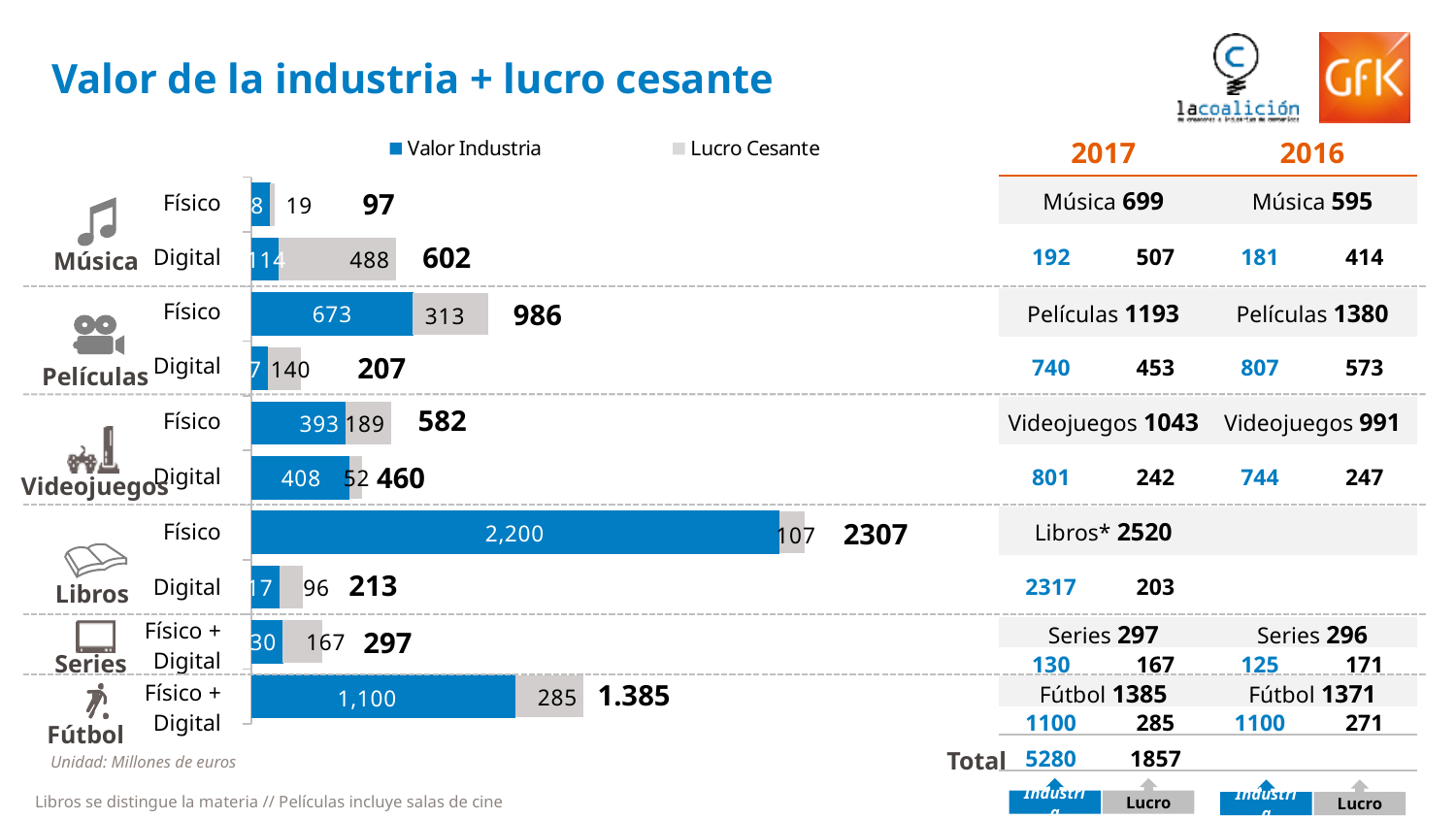
Which bar has the largest total value? Libros Físico What is the Lucro Cesante value for Fútbol (Físico + Digital)? 285 What is the Lucro Cesante value for Música Digital? 488 How many series does the chart legend list? 2 What is the Valor Industria value for Películas Físico? 673 What is the Valor Industria value for Libros Físico? 2,200 What is the difference between Valor Industria and Lucro Cesante for Películas Físico? 360 How many bars are plotted in the chart? 10 Which has a larger Lucro Cesante value, Fútbol or Series? Fútbol What kind of chart is shown on the slide? bar chart Which bar has the smallest total value? Música Físico What is the total of the stacked bar for Videojuegos Físico? 582